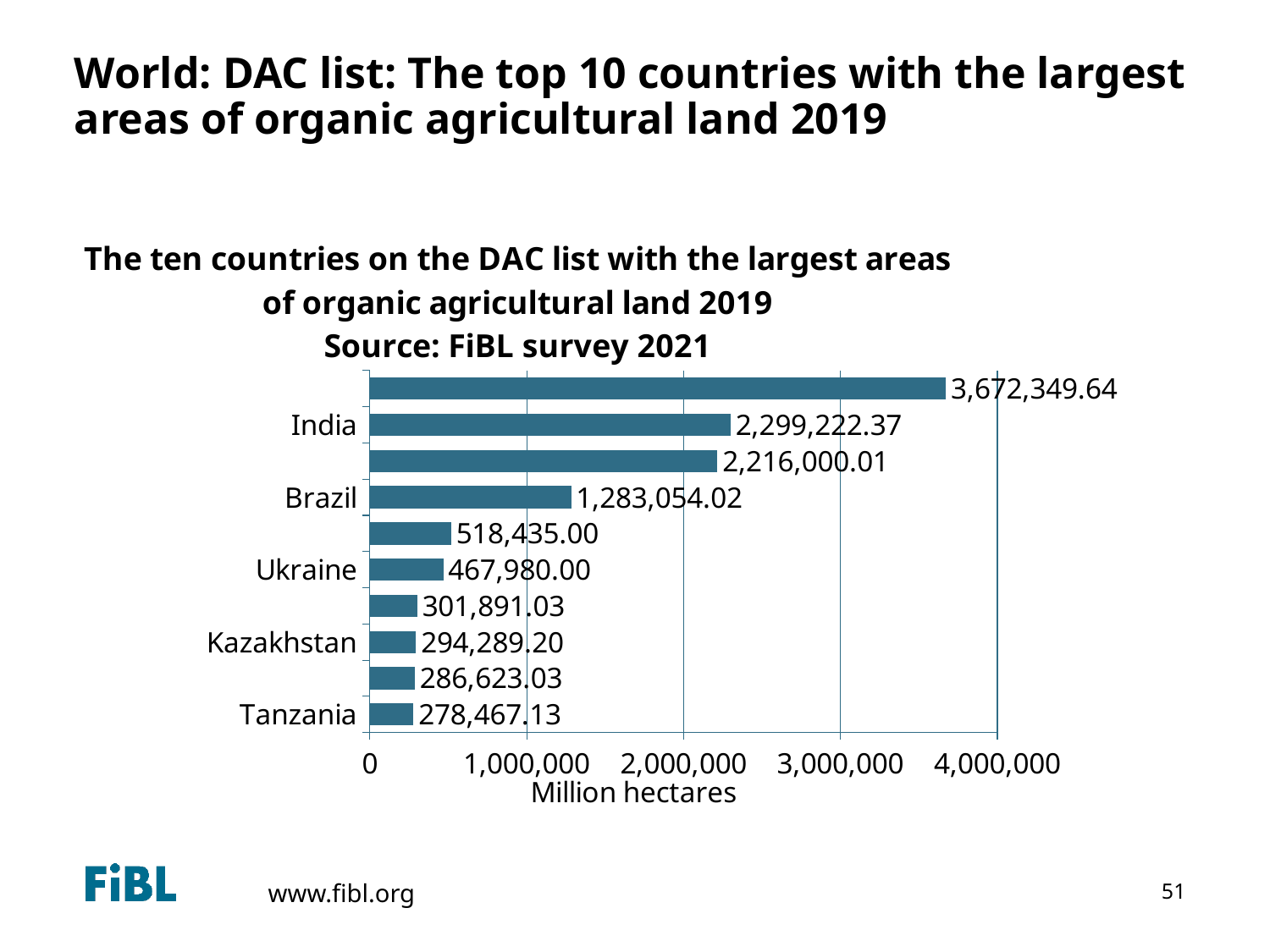
How many bars are shown in the chart? 10 What is the value for Ukraine? 467,980.00 Which is larger, the value for Ukraine or the value for Tanzania? Ukraine What is the difference between the values for India and Brazil? 1,016,168.35 What kind of chart is shown on the slide? bar chart What is the value for Brazil? 1,283,054.02 What is the difference between the values for Kazakhstan and Tanzania? 15,822.07 What is the value for Tanzania? 278,467.13 Which labelled country has the lowest value? Tanzania What is the value for Kazakhstan? 294,289.20 What is the value for India? 2,299,222.37 Is the value for Brazil greater or less than 2,000,000? less